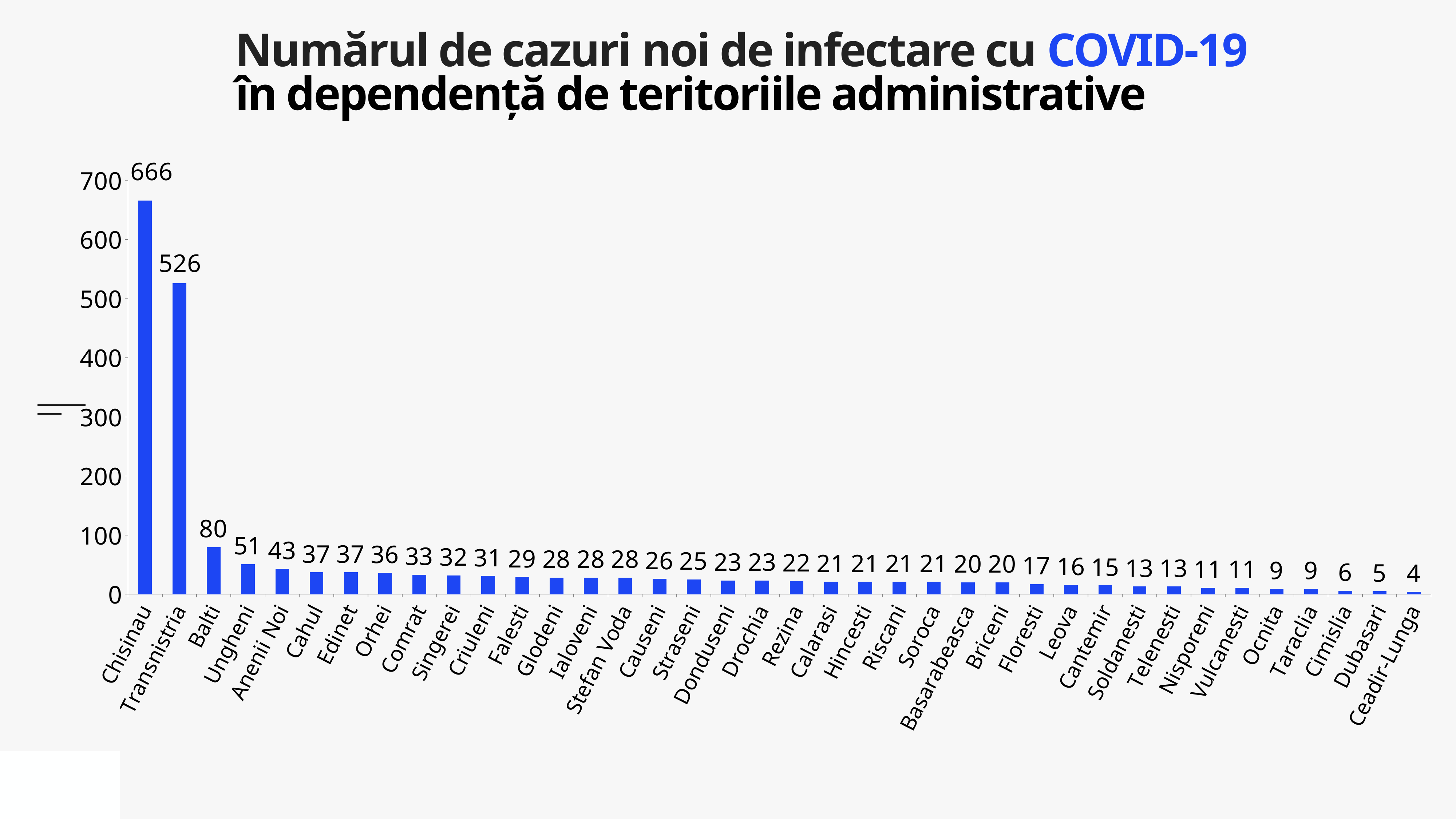
What kind of chart is shown on the slide? bar chart Which territory has the lowest number of new cases? Ceadir-Lunga What is the value for Transnistria? 526 What is the value for Balti? 80 Do the values rise or fall from left to right along the x axis? fall What is the value for Ceadir-Lunga? 4 Which territory has the highest number of new cases? Chisinau What is the value for Chisinau? 666 What is the difference between the values for Chisinau and Transnistria? 140 Is the value for Transnistria greater or less than 500? greater How many territories are shown on the chart? 38 Which has a larger value, Ungheni or Anenii Noi? Ungheni